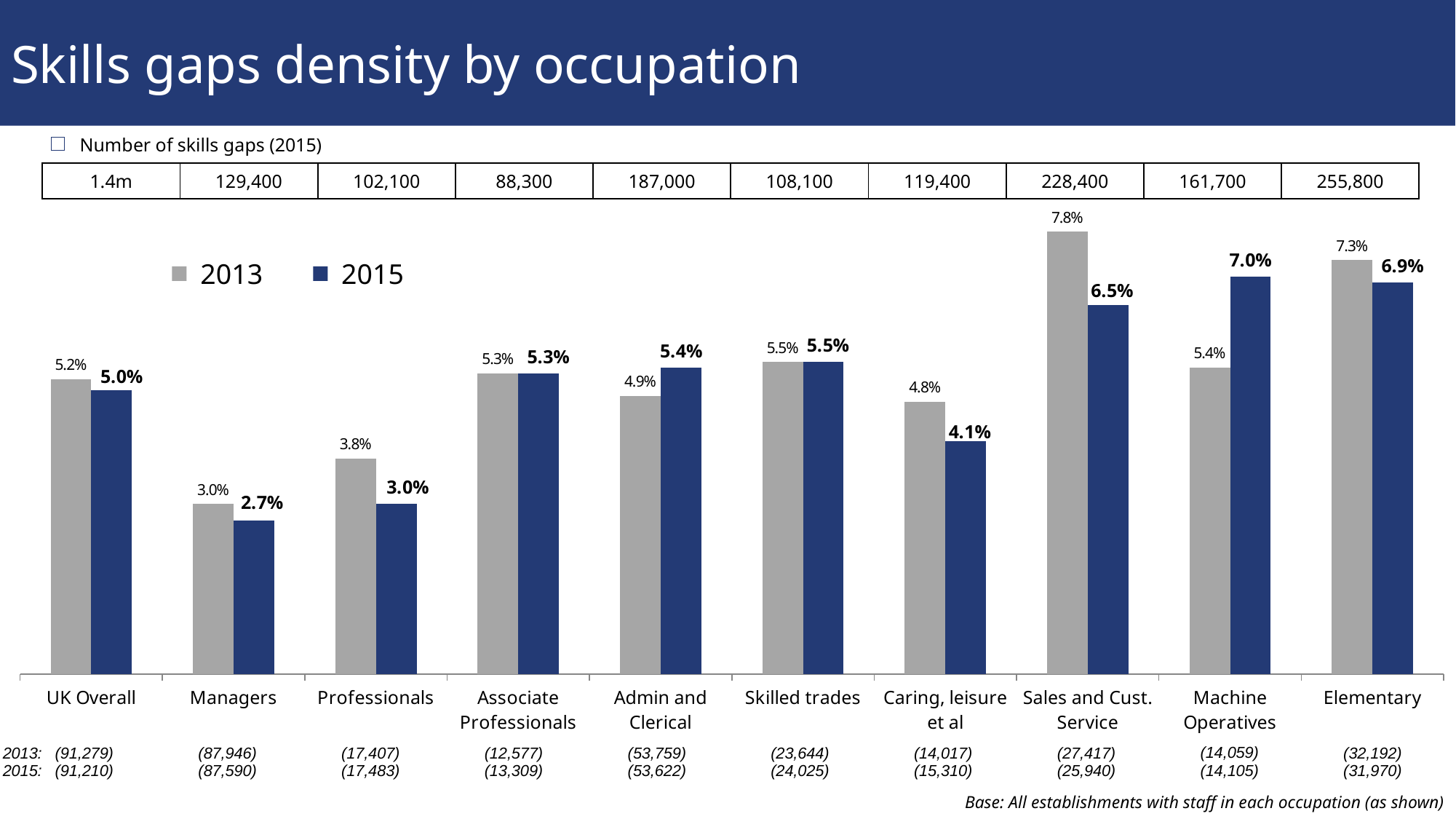
How many occupation categories are shown on the x axis, including UK Overall? 10 Which occupation has the highest 2015 skills gap density? Machine Operatives What is the difference between the 2013 and 2015 skills gap density for Sales and Cust. Service? 1.3% What is the 2015 skills gap density for Managers? 2.7% Which occupation has the lowest 2013 skills gap density? Managers What kind of chart is shown on the slide? Bar chart How many series does the legend list? 2 Which colour represents the 2013 series in the legend? Grey Which is larger for Admin and Clerical: the 2013 value or the 2015 value? 2015 What is the number of skills gaps (2015) shown for Elementary? 255,800 What is the 2013 skills gap density for Sales and Cust. Service? 7.8% What is the 2015 skills gap density for Machine Operatives? 7.0%